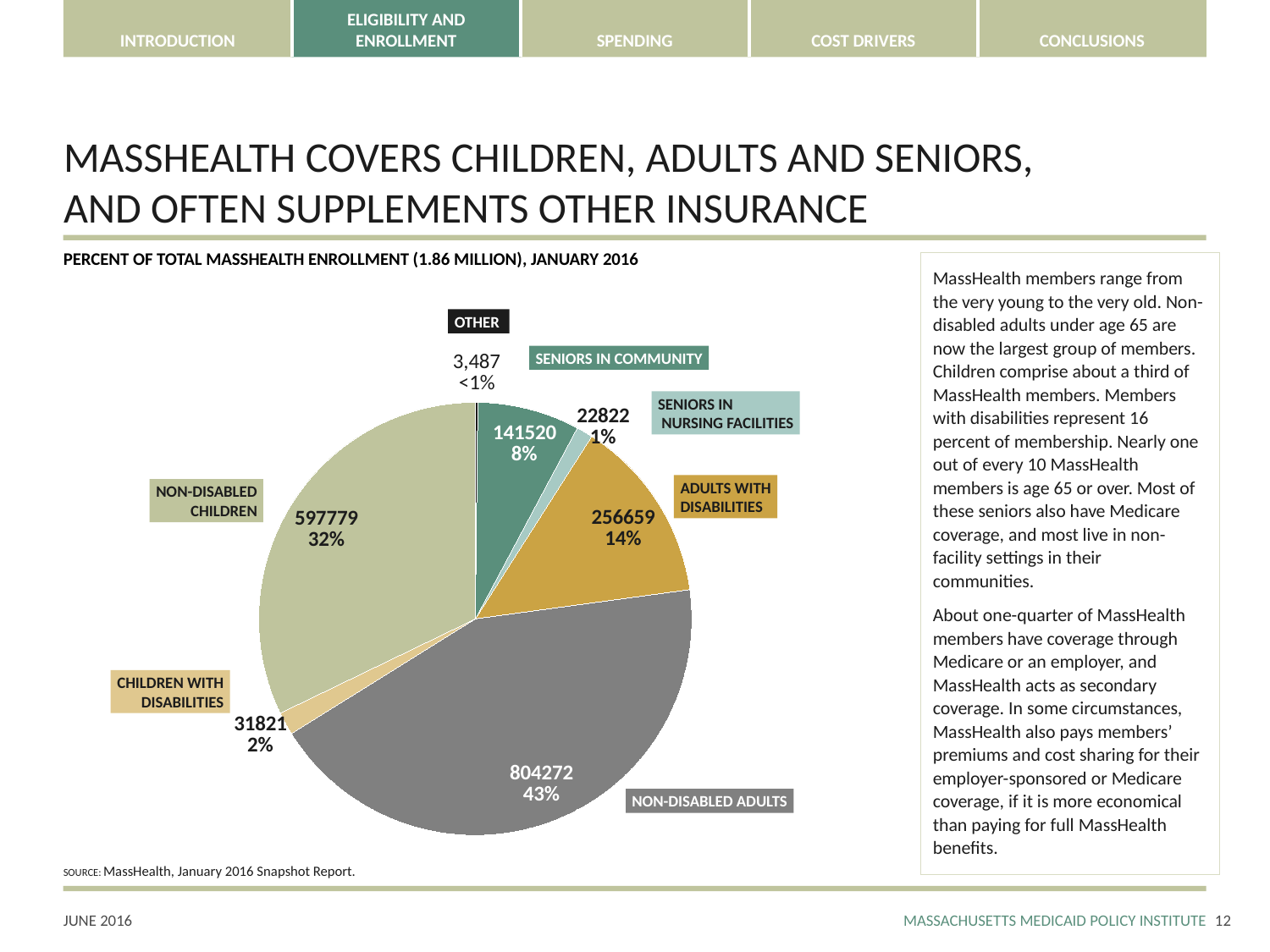
What percent of total MassHealth enrollment is Non-Disabled Children? 32% What is the title of the chart? Percent of Total MassHealth Enrollment (1.86 Million), January 2016 What is the difference in enrollment between Non-Disabled Adults and Non-Disabled Children? 206493 What is the enrollment count for Adults with Disabilities? 256659 Which is larger, the enrollment for Children with Disabilities or for Seniors in Nursing Facilities? Children with Disabilities How many slices does the pie chart have? 7 What percent of enrollment is Seniors in Community? 8% Which category has the largest share of enrollment? Non-Disabled Adults What is the enrollment count for Non-Disabled Adults? 804272 What kind of chart is shown on the slide? Pie chart What is the enrollment count for Seniors in Nursing Facilities? 22822 Which category has the smallest share of enrollment? Other